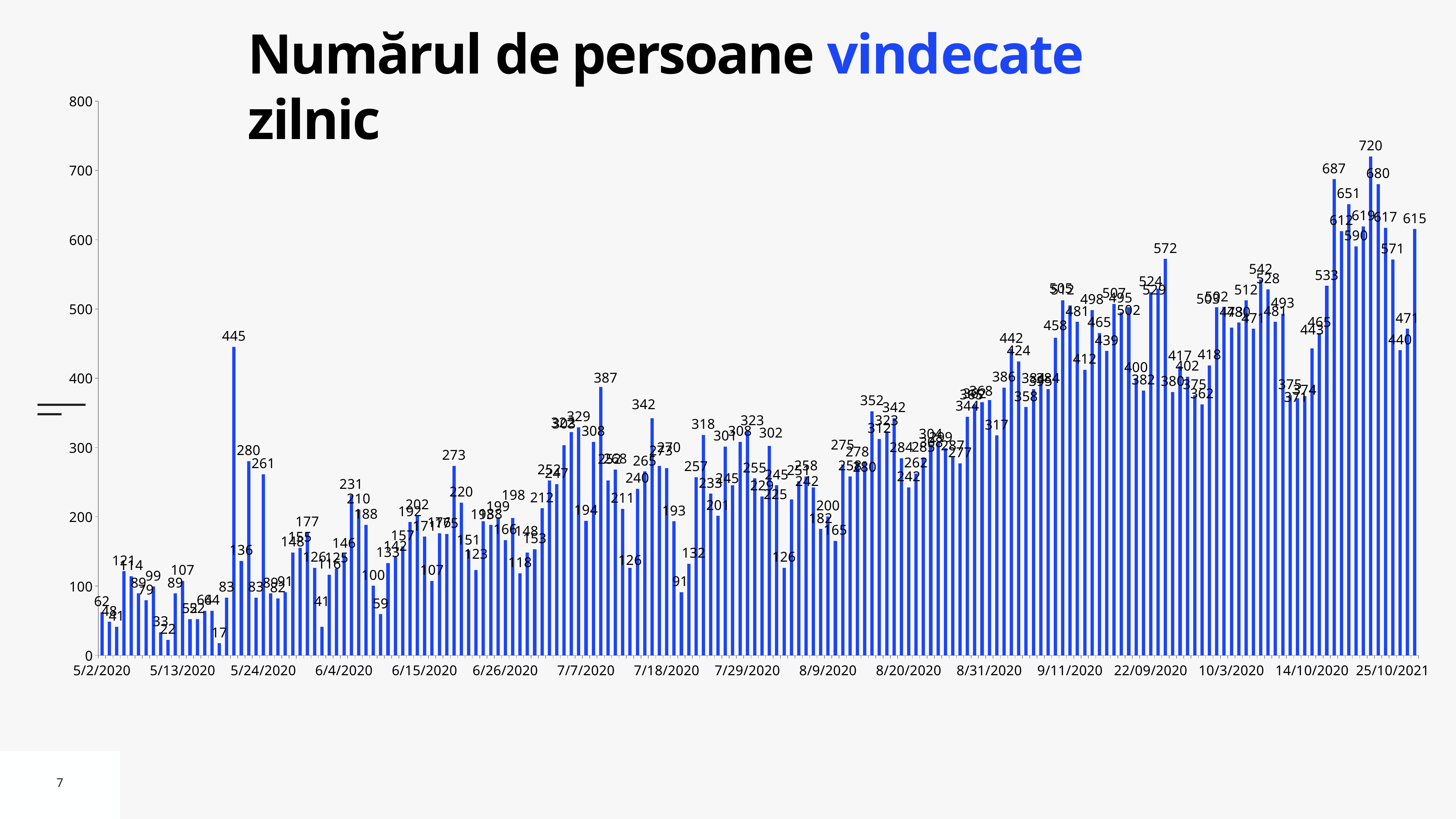
What is the value of the first bar, at 5/2/2020? 62 What is the title of the chart? Numărul de persoane vindecate zilnic Overall, do the values rise or fall from left to right along the x axis? rise What is the highest value shown in the chart? 720 What is the difference between the last bar (615) and the first bar (62)? 553 Is the value of the first bar (5/2/2020) greater or less than 100? less What colour are the bars in the chart? blue What is the lowest value shown in the chart? 17 What is the difference between the highest value (720) and the value of the last bar (615)? 105 What kind of chart is shown on the slide? bar chart Which is larger, the bar labelled 445 in May 2020 or the bar labelled 387 in July 2020? 445